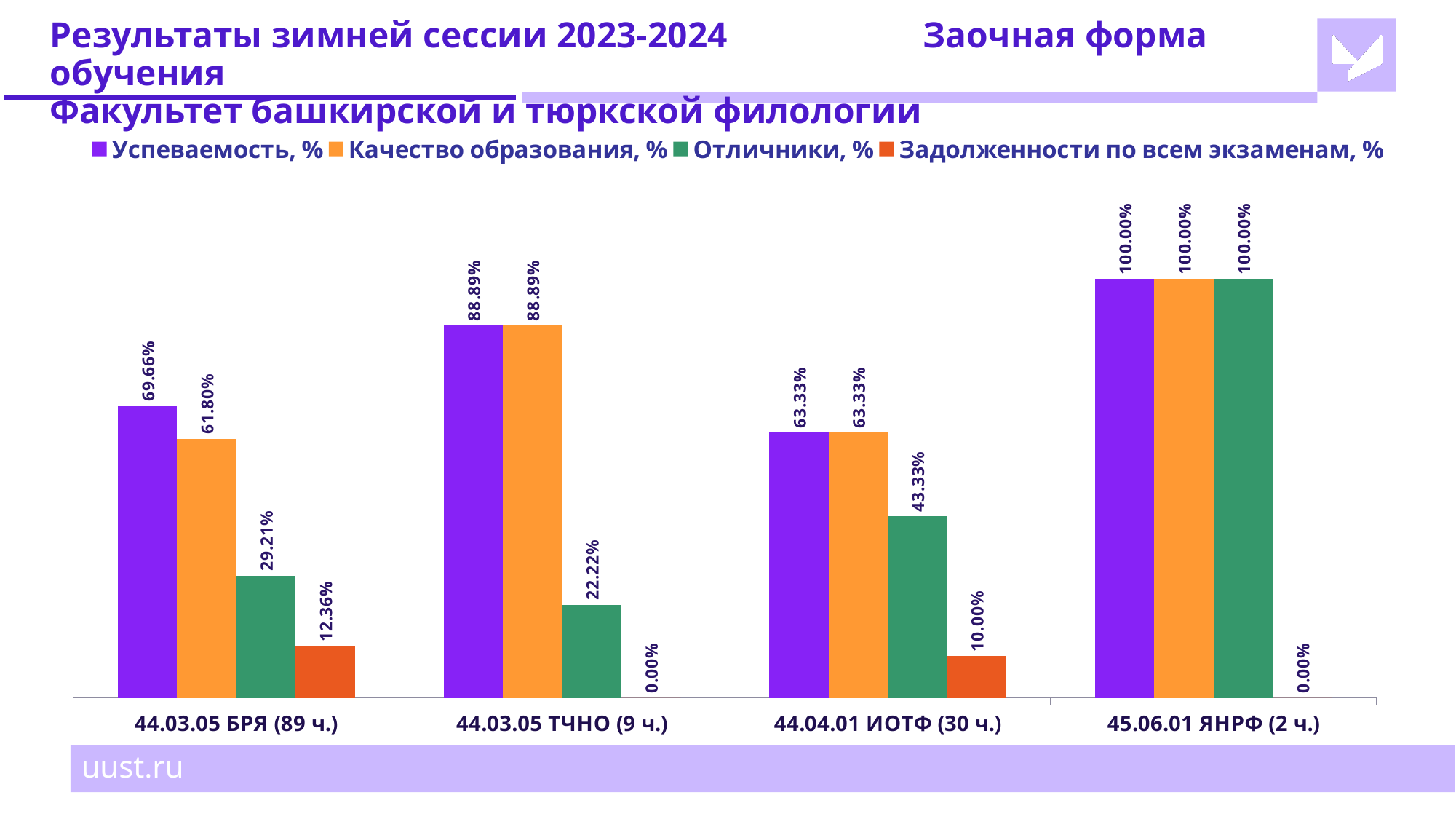
Which category has the lowest value of Успеваемость, %? 44.04.01 ИОТФ (30 ч.) What is the value of Отличники, % for 44.04.01 ИОТФ (30 ч.)? 43.33% Which category has the highest value of Отличники, %? 45.06.01 ЯНРФ (2 ч.) What is the difference between Успеваемость, % and Качество образования, % for 44.03.05 БРЯ (89 ч.)? 7.86% What is the value of Задолженности по всем экзаменам, % for 44.03.05 БРЯ (89 ч.)? 12.36% What kind of chart is shown on the slide? Bar chart What is the value of Качество образования, % for 44.03.05 ТЧНО (9 ч.)? 88.89% Which is larger: Отличники, % for 44.03.05 БРЯ (89 ч.) or for 44.04.01 ИОТФ (30 ч.)? 44.04.01 ИОТФ (30 ч.) How many categories are shown on the x axis? 4 How many series does the legend list? 4 What is the value of Успеваемость, % for 44.03.05 БРЯ (89 ч.)? 69.66% Which colour represents Задолженности по всем экзаменам, % in the legend? Red-orange